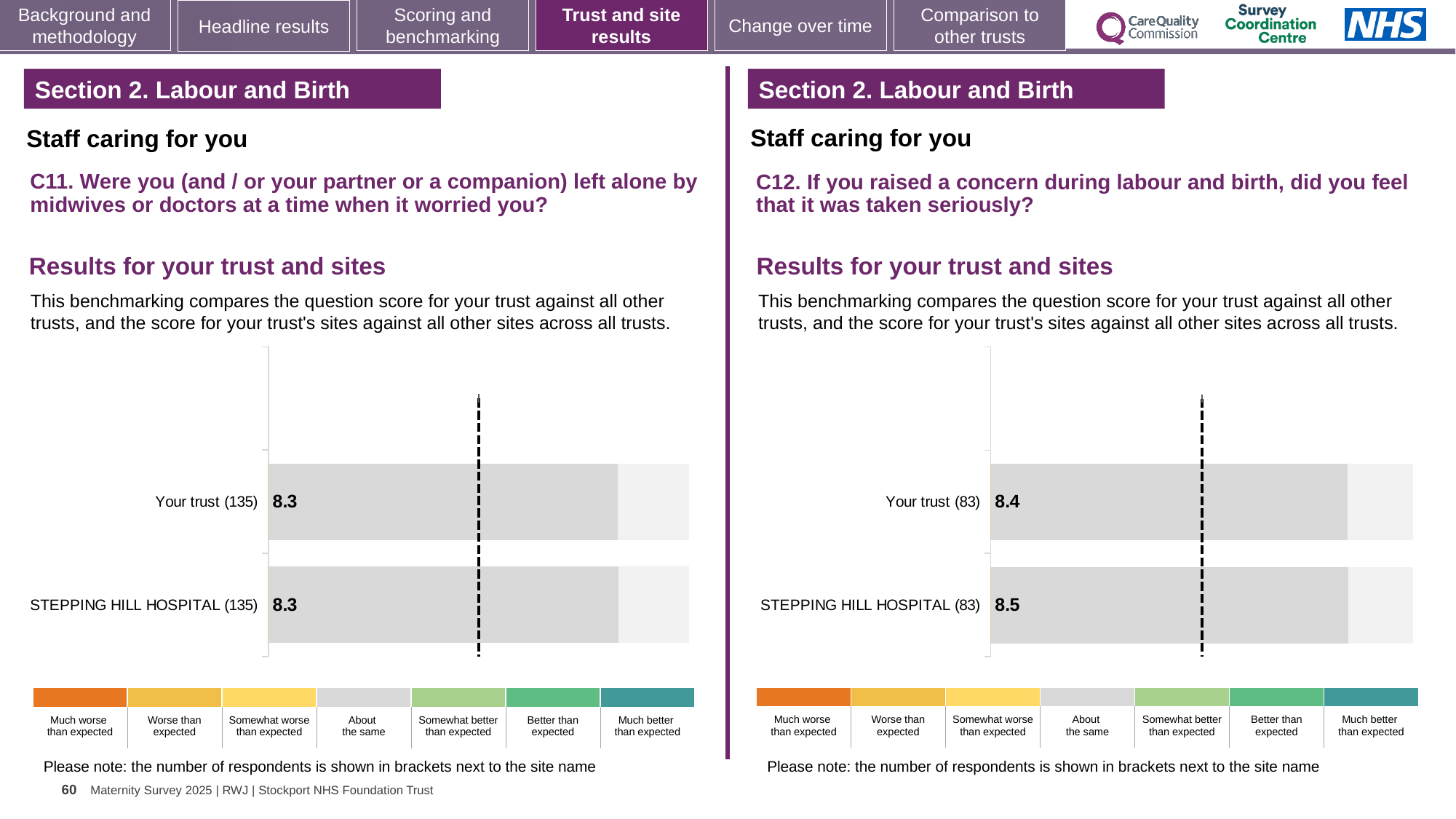
In the C12 chart on the right, what is the score for STEPPING HILL HOSPITAL? 8.5 In the C11 chart on the left, what is the score for STEPPING HILL HOSPITAL? 8.3 How many bars are plotted in the C11 chart on the left? 2 In the C12 chart on the right, what is the difference between the STEPPING HILL HOSPITAL score and the Your trust score? 0.1 In the C11 chart on the left, is the score for Your trust higher than, lower than, or equal to the score for STEPPING HILL HOSPITAL? equal In the C11 chart on the left, what is the score for Your trust? 8.3 How many categories does the colour key below the C11 chart on the left list, from 'Much worse than expected' to 'Much better than expected'? 7 In the C11 chart on the left, how many respondents are shown in brackets for Your trust? 135 In the C12 chart on the right, how many respondents are shown in brackets for STEPPING HILL HOSPITAL? 83 In the C12 chart on the right, which has the higher score, Your trust or STEPPING HILL HOSPITAL? STEPPING HILL HOSPITAL What type of chart is used for the C12 results on the right? bar chart In the C12 chart on the right, what is the score for Your trust? 8.4